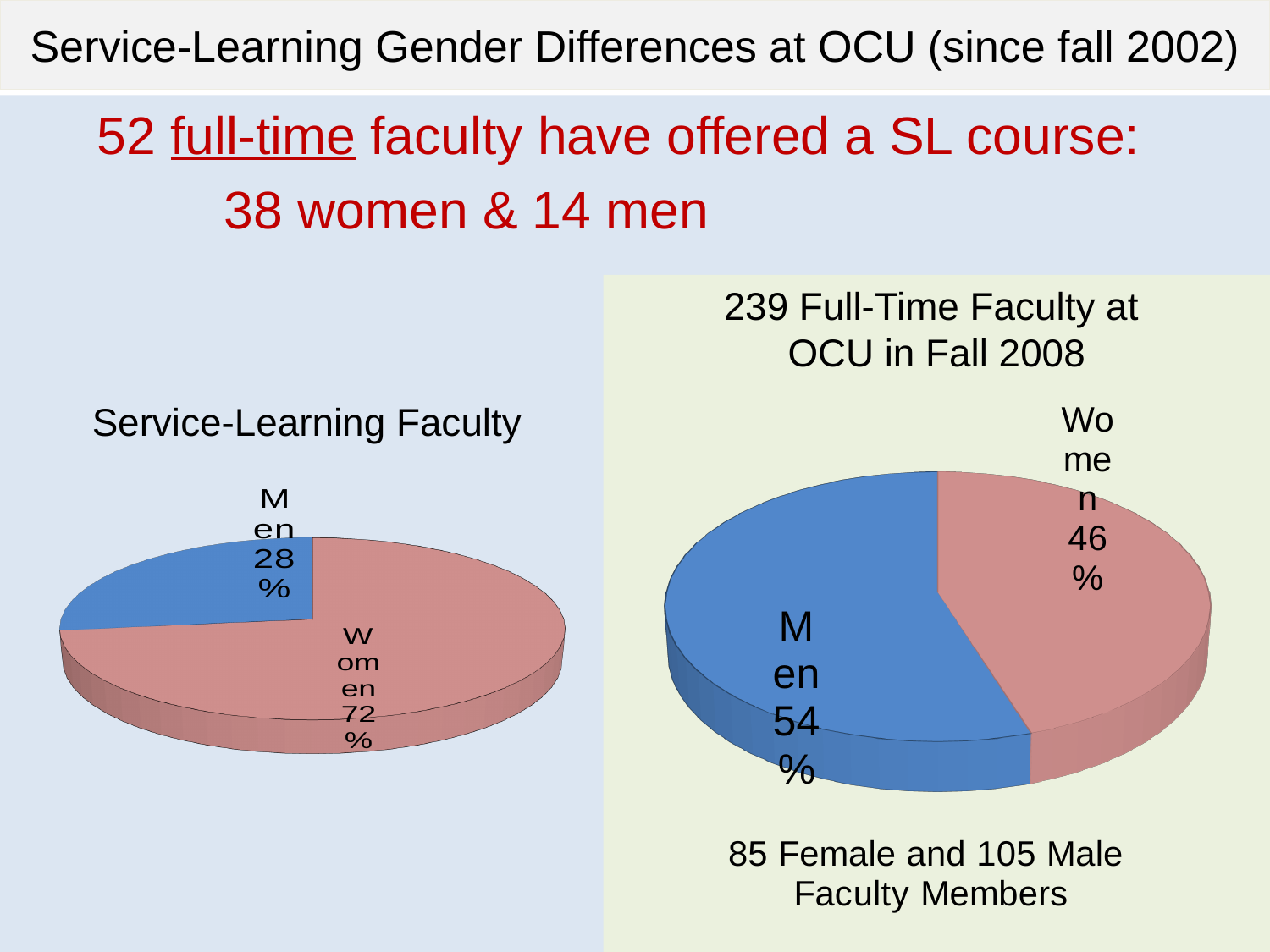
In the 'Service-Learning Faculty' chart, what is the difference in percentage points between the Women and Men slices? 44 In the 'Service-Learning Faculty' chart, what share of the pie is Men? 28% In the 'Service-Learning Faculty' chart, which slice is the largest? Women In the '239 Full-Time Faculty at OCU in Fall 2008' chart, which slice is larger, Men or Women? Men In the 'Service-Learning Faculty' chart, what share of the pie is Women? 72% In the '239 Full-Time Faculty at OCU in Fall 2008' chart, which slice is the smallest? Women In the '239 Full-Time Faculty at OCU in Fall 2008' chart, what share of the pie is Women? 46% In the '239 Full-Time Faculty at OCU in Fall 2008' chart, what is the difference in percentage points between the Men and Women slices? 8 What kind of chart is the 'Service-Learning Faculty' chart? Pie chart How many slices does the '239 Full-Time Faculty at OCU in Fall 2008' chart have? 2 In the 'Service-Learning Faculty' chart, what colour is the Men slice? Blue